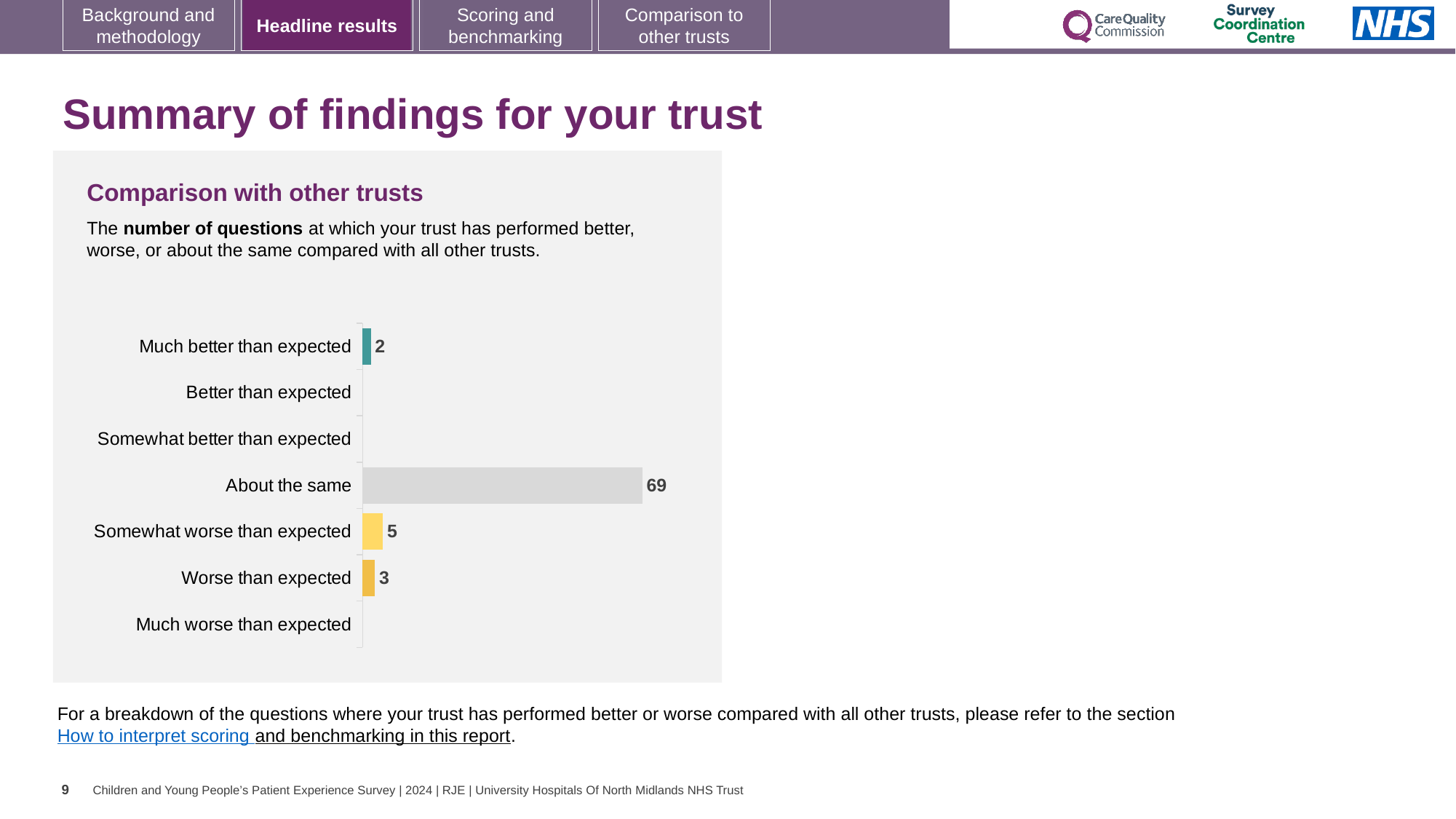
What kind of chart is shown on the slide? Bar chart How many questions were rated 'Somewhat worse than expected'? 5 How many categories are shown on the chart? 7 What is the title of the chart section? Comparison with other trusts What is the difference between the number of questions rated 'About the same' and 'Somewhat worse than expected'? 64 What is the total number of questions rated worse than expected across 'Somewhat worse than expected' and 'Worse than expected'? 8 How many questions were rated 'Much better than expected'? 2 What is the difference between the number of questions rated 'Somewhat worse than expected' and 'Worse than expected'? 2 How many questions were rated 'Worse than expected'? 3 How many questions were rated 'About the same'? 69 Which category has the highest number of questions? About the same Which is larger: the number of questions rated 'Somewhat worse than expected' or 'Much better than expected'? Somewhat worse than expected